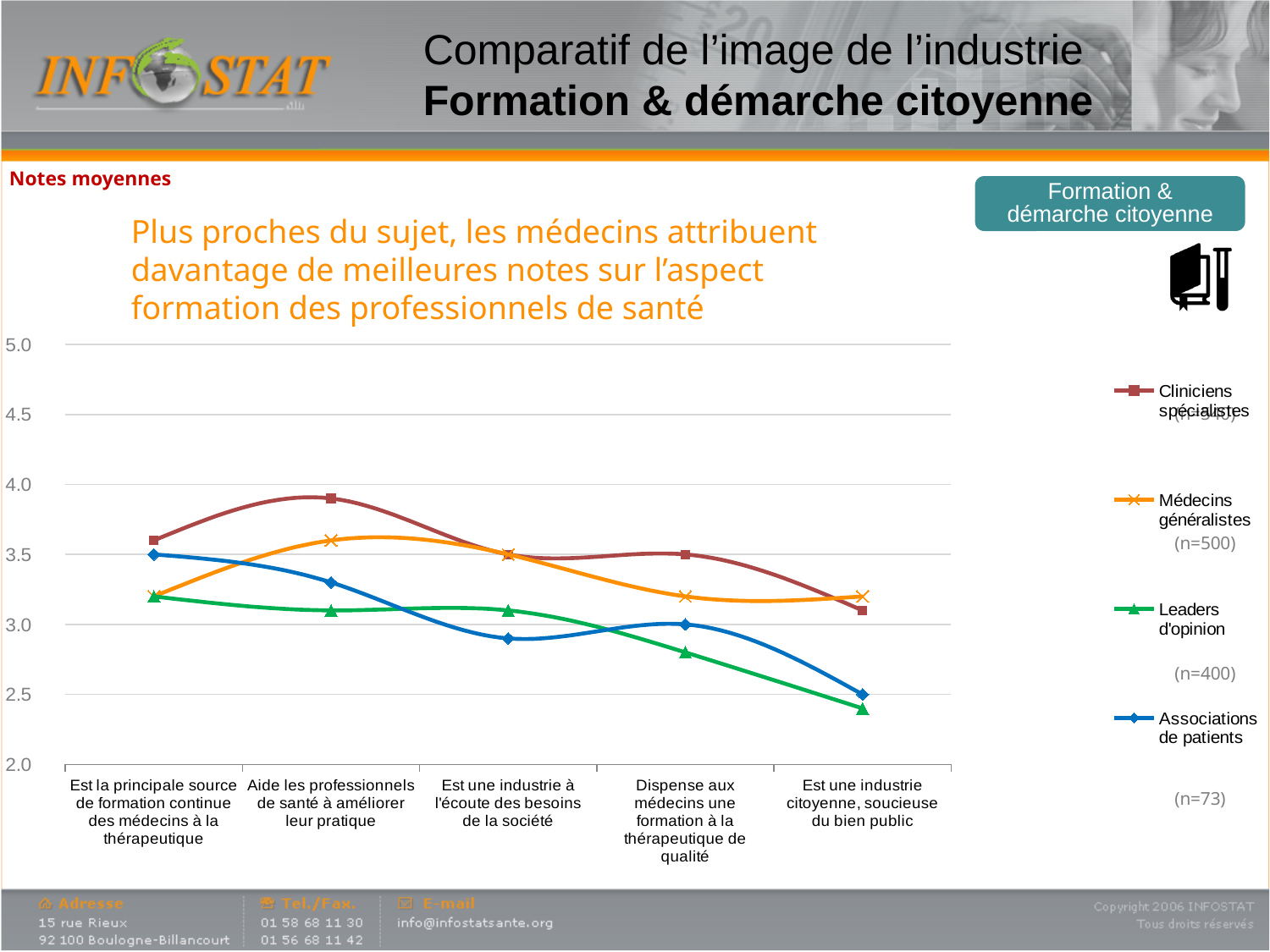
What sample size does the legend give for Médecins généralistes? n=500 Which series has the lowest value for "Est une industrie à l'écoute des besoins de la société"? Associations de patients Do the values for Leaders d'opinion rise or fall from left to right along the x axis? fall For "Dispense aux médecins une formation à la thérapeutique de qualité", which is larger: Associations de patients or Leaders d'opinion? Associations de patients Is the value for Médecins généralistes on "Est la principale source de formation continue des médecins à la thérapeutique" greater or less than 3.0? greater What kind of chart is shown on the slide? line chart How many categories are shown along the x axis? 5 Is the value for Cliniciens spécialistes on "Aide les professionnels de santé à améliorer leur pratique" greater or less than 3.5? greater Is the value for Leaders d'opinion on "Est une industrie citoyenne, soucieuse du bien public" greater or less than 2.5? less Which series has the highest value for "Aide les professionnels de santé à améliorer leur pratique"? Cliniciens spécialistes How many series does the legend list? 4